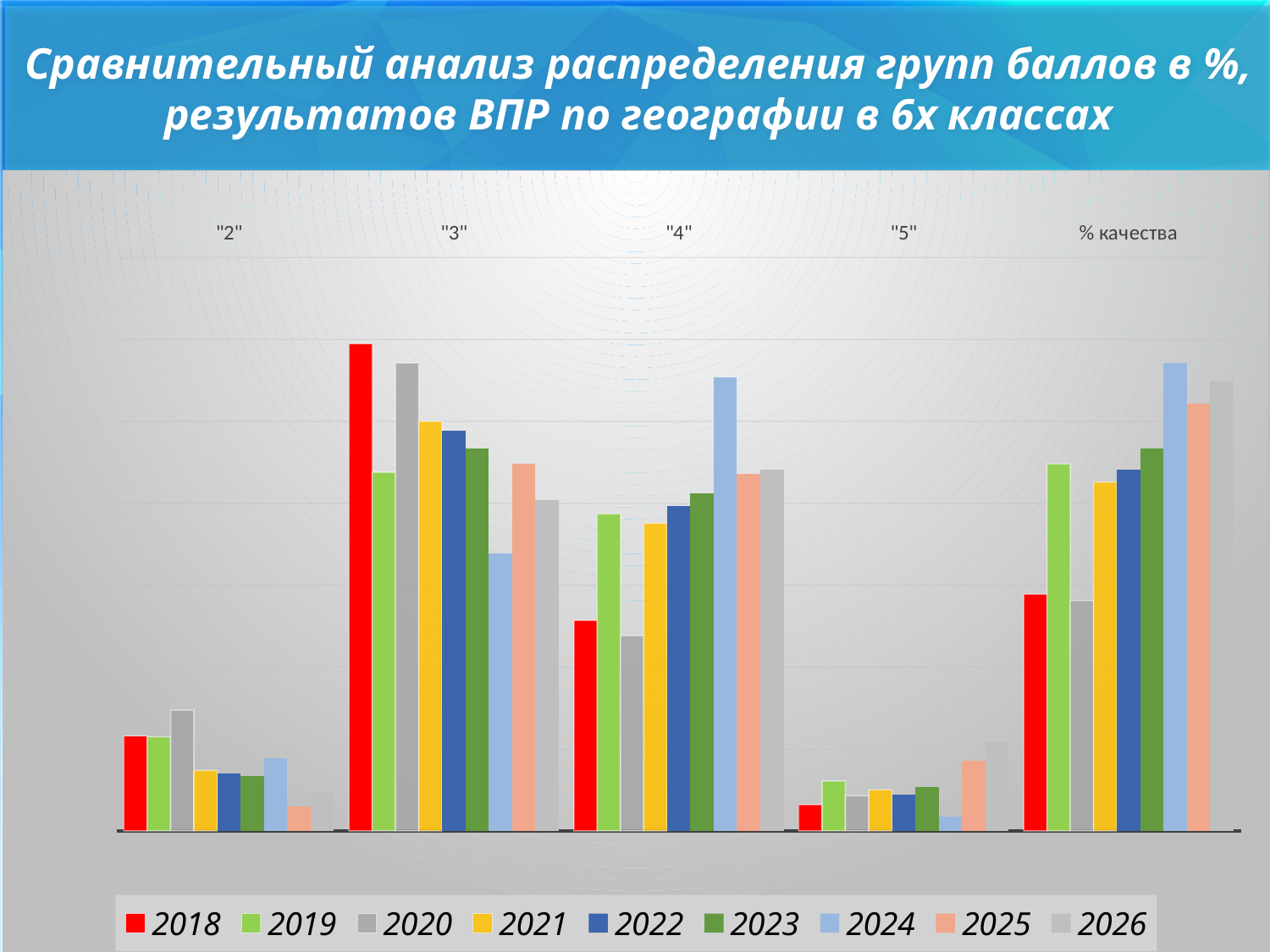
In the "3" category, which year has the lowest bar? 2024 How many series does the chart legend list? 9 Which year is listed first in the chart legend? 2018 How many categories are shown along the x axis of the chart? 5 In the "3" category, which year has the highest bar? 2018 What kind of chart is shown on the slide? bar chart In the "% качества" category, which is larger: the value for 2019 or the value for 2020? 2019 In the "4" category, which year has the highest bar? 2024 In the "5" category, which year has the lowest bar? 2024 In the "3" category, which is larger: the value for 2018 or the value for 2019? 2018 What is the label of the last category on the x axis? % качества In the "2" category, which year has the highest bar? 2020